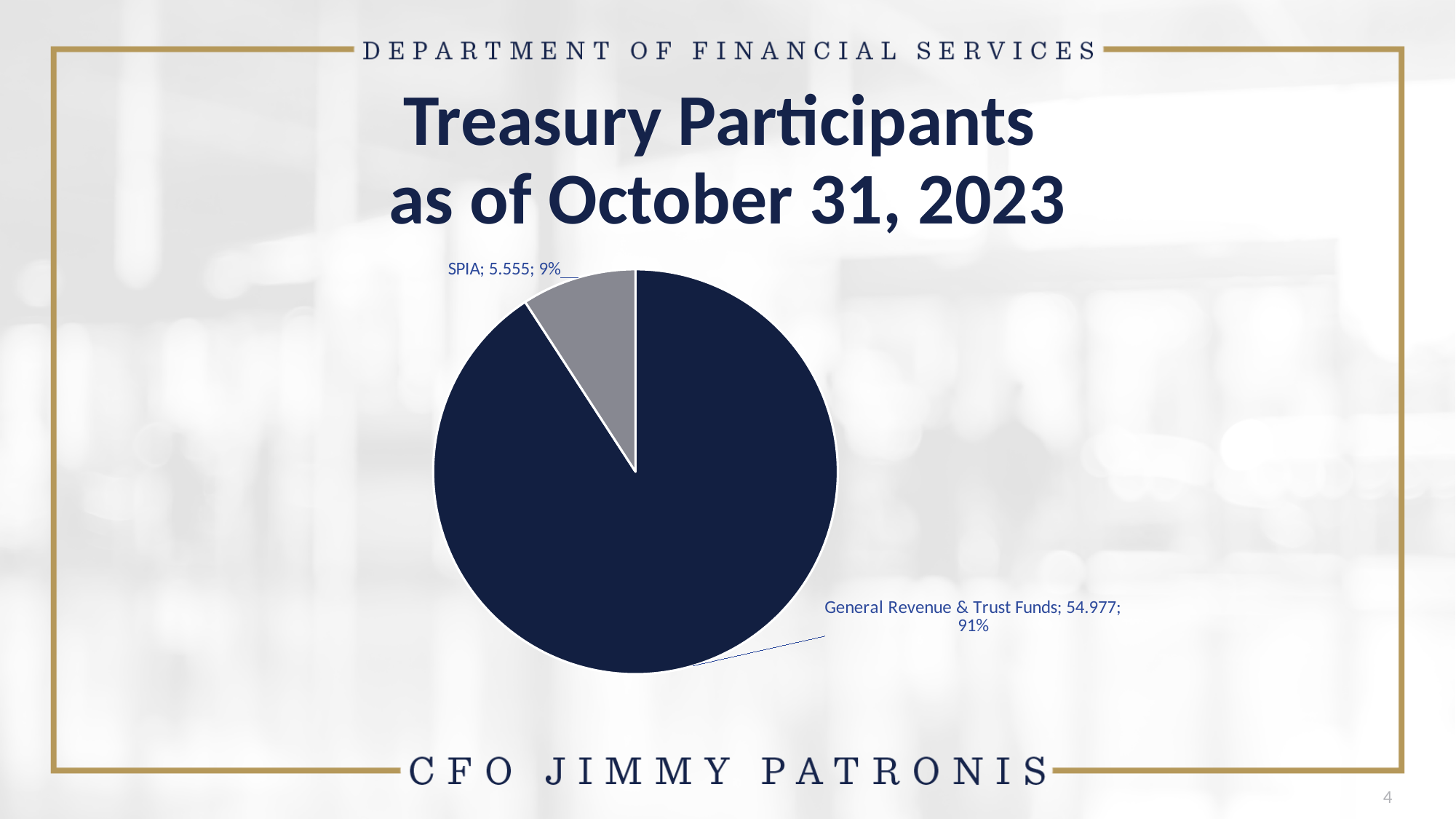
What is the difference between the value for General Revenue & Trust Funds and the value for SPIA? 49.422 Which is larger, the value for SPIA or the value for General Revenue & Trust Funds? General Revenue & Trust Funds Which slice of the pie is the smallest? SPIA What is the title of the slide containing the pie chart? Treasury Participants as of October 31, 2023 What share of the pie does General Revenue & Trust Funds represent? 91% What share of the pie does SPIA represent? 9% What colour is the SPIA slice of the pie? Grey What type of chart is shown on the slide? Pie chart How many slices does the pie chart have? 2 What is the value shown for SPIA? 5.555 Which slice of the pie is the largest? General Revenue & Trust Funds What is the value shown for General Revenue & Trust Funds? 54.977